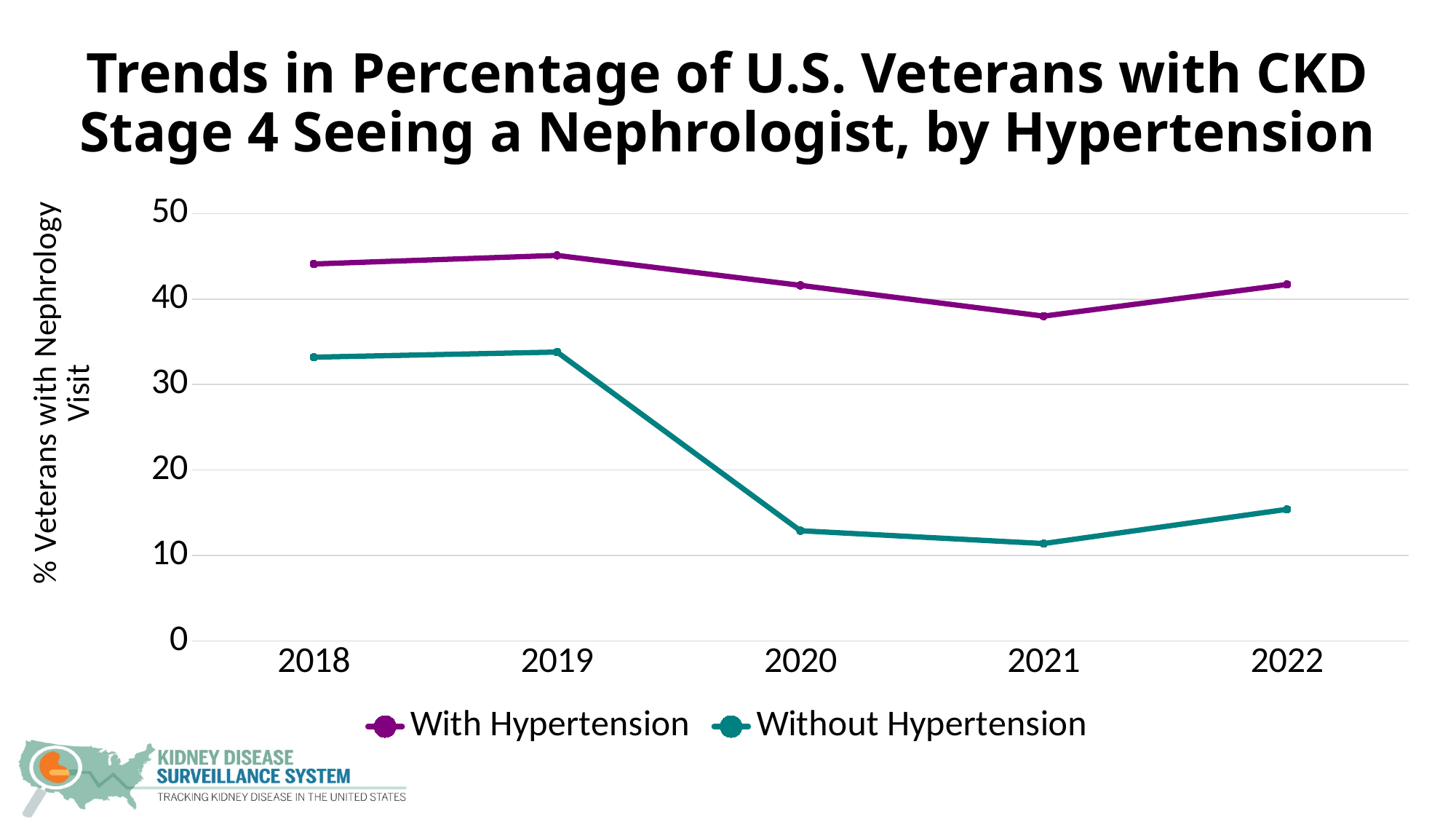
In which year is the With Hypertension series at its lowest? 2021 What is the label of the y axis? % Veterans with Nephrology Visit Is the value for Without Hypertension in 2018 greater or less than 30? greater Is the value for Without Hypertension in 2020 greater or less than 20? less How many years are plotted along the x axis? 5 In which year is the Without Hypertension series at its lowest? 2021 Does the Without Hypertension series rise or fall between 2019 and 2020? Fall Which series has the higher value in 2020, With Hypertension or Without Hypertension? With Hypertension What type of chart is shown on the slide? Line chart Is the value for With Hypertension in 2018 greater or less than 40? greater How many series does the legend list? 2